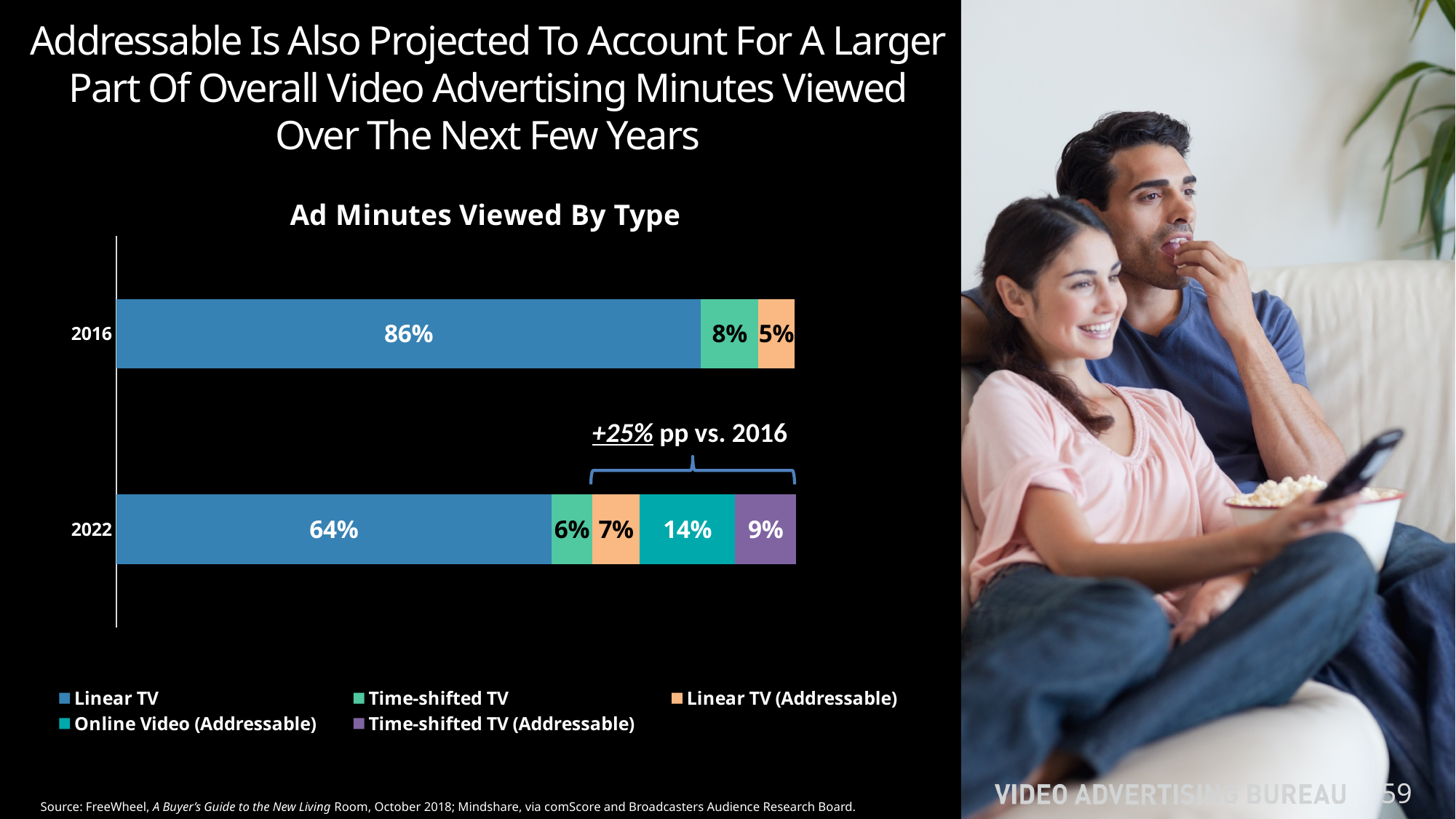
What kind of chart is shown on the slide? Stacked bar chart What is the value for Time-shifted TV (Addressable) in 2022? 9% What share of ad minutes viewed is Linear TV in 2016? 86% What is the title of the chart? Ad Minutes Viewed By Type By how many percentage points does the Linear TV share fall from 2016 to 2022? 22 What is the value for Linear TV (Addressable) in 2016? 5% How many years (bars) are shown in the chart? 2 Which is larger in 2022: Time-shifted TV or Linear TV (Addressable)? Linear TV (Addressable) What share of ad minutes viewed is Linear TV in 2022? 64% What is the value for Online Video (Addressable) in 2022? 14% How many series does the chart legend list? 5 Which segment is the largest in the 2022 bar? Linear TV